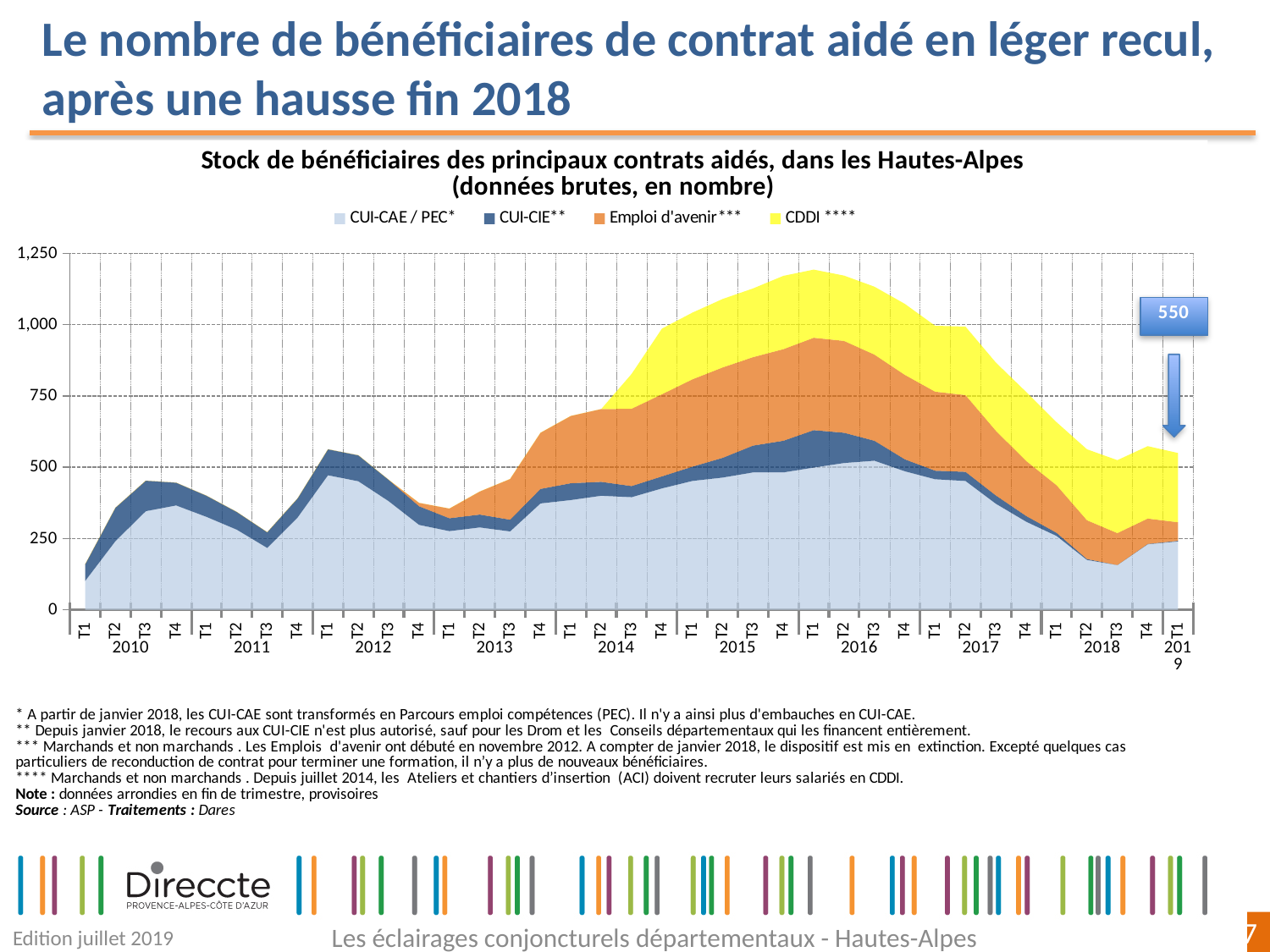
Which series is shown in yellow? CDDI **** Which is larger, the total stock of beneficiaries at T1 2016 or at T1 2010? T1 2016 Does the total stock of beneficiaries rise or fall between T1 2016 and T3 2018? fall What is the highest value shown on the vertical axis? 1,250 Is the total stock of beneficiaries at T1 2010 greater or less than 250? less In which year does the total stock of beneficiaries reach its highest level? 2016 Is the total stock of beneficiaries at T1 2016 greater or less than 1,000? greater What kind of chart is shown on the slide? area chart Is the total stock of beneficiaries at T3 2018 greater or less than 750? less What is the total stock of beneficiaries shown for T1 2019, as printed in the callout? 550 How many series does the legend list? 4